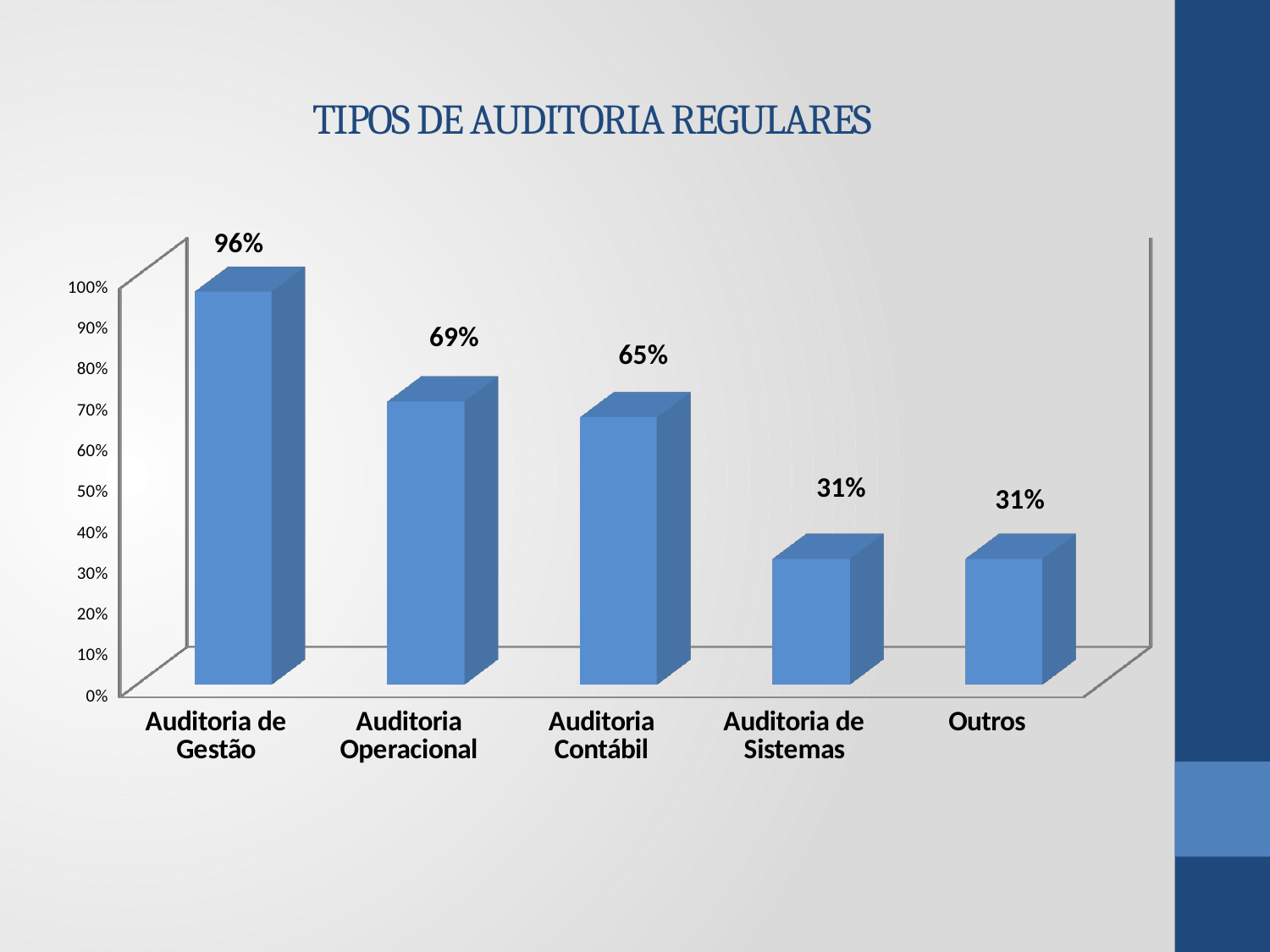
How many categories are shown in the chart? 5 What is the value for Outros? 31% Which is larger, the value for Auditoria Operacional or the value for Auditoria Contábil? Auditoria Operacional What is the difference between the values for Auditoria de Gestão and Auditoria Operacional? 27% What is the title of the chart? TIPOS DE AUDITORIA REGULARES What is the value for Auditoria de Gestão? 96% Which category has the highest value? Auditoria de Gestão What is the value for Auditoria Operacional? 69% What is the difference between the values for Auditoria Contábil and Auditoria de Sistemas? 34% What is the value for Auditoria de Sistemas? 31% What is the value for Auditoria Contábil? 65% What kind of chart is shown on the slide? Bar chart